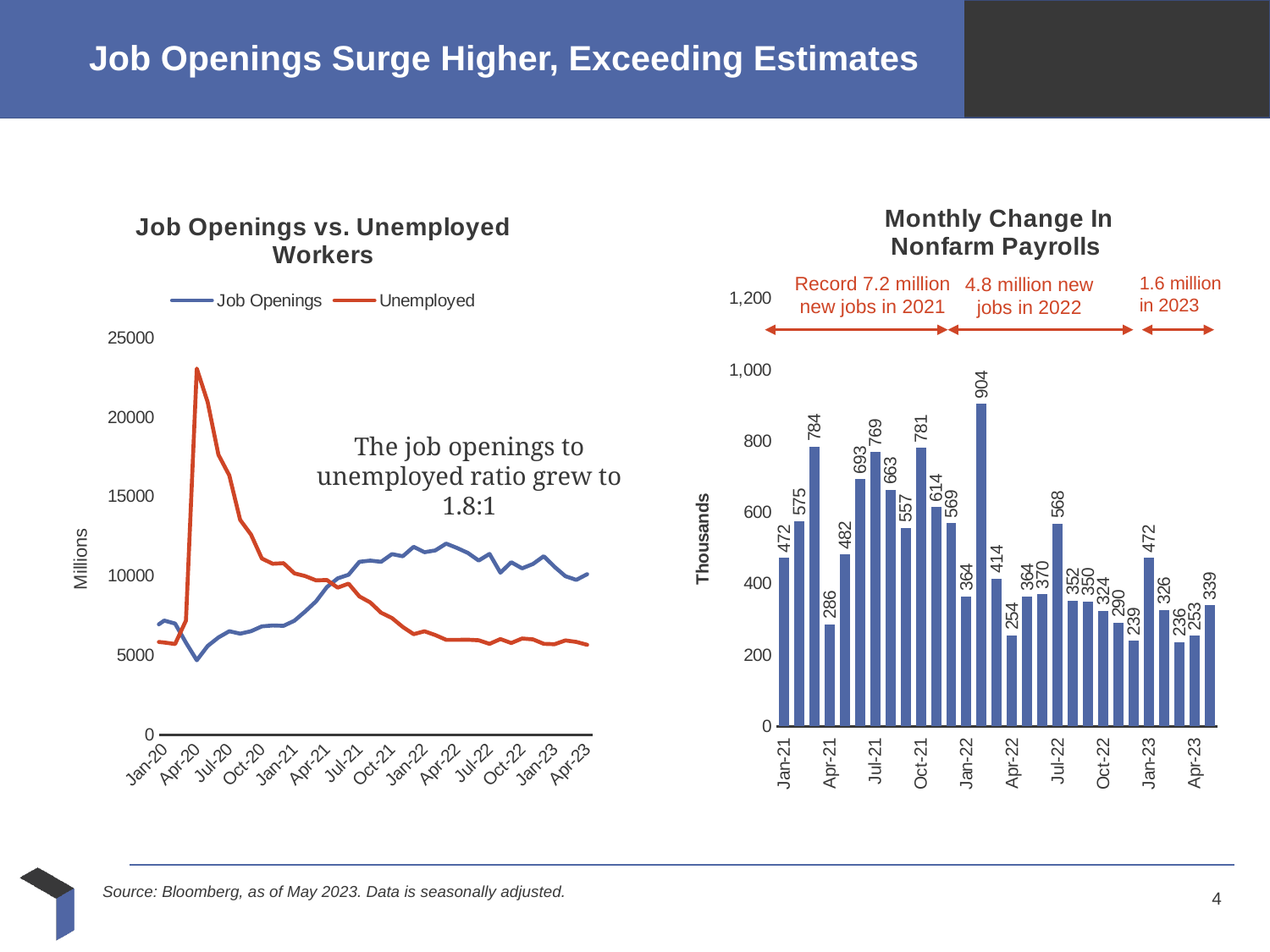
On the Monthly Change In Nonfarm Payrolls chart, what is the highest value shown on any bar? 904 How many series does the legend of the Job Openings vs. Unemployed Workers chart list? 2 On the Monthly Change In Nonfarm Payrolls chart, what is the value for Jul-22? 568 On the Monthly Change In Nonfarm Payrolls chart, what is the value for Jan-21? 472 On the Monthly Change In Nonfarm Payrolls chart, what is the value for Apr-23? 253 On the Job Openings vs. Unemployed Workers chart, is the peak value of the Unemployed series greater or less than 20000? greater On the Monthly Change In Nonfarm Payrolls chart, what is the lowest value shown on any bar? 236 On the Monthly Change In Nonfarm Payrolls chart, what is the difference between the values for Jul-21 and Jul-22? 201 What is the y-axis label on the Monthly Change In Nonfarm Payrolls chart? Thousands On the Monthly Change In Nonfarm Payrolls chart, how many bars are plotted? 29 What kind of chart is the Monthly Change In Nonfarm Payrolls chart? Bar chart On the Monthly Change In Nonfarm Payrolls chart, which is larger, the value for Oct-21 or Oct-22? Oct-21